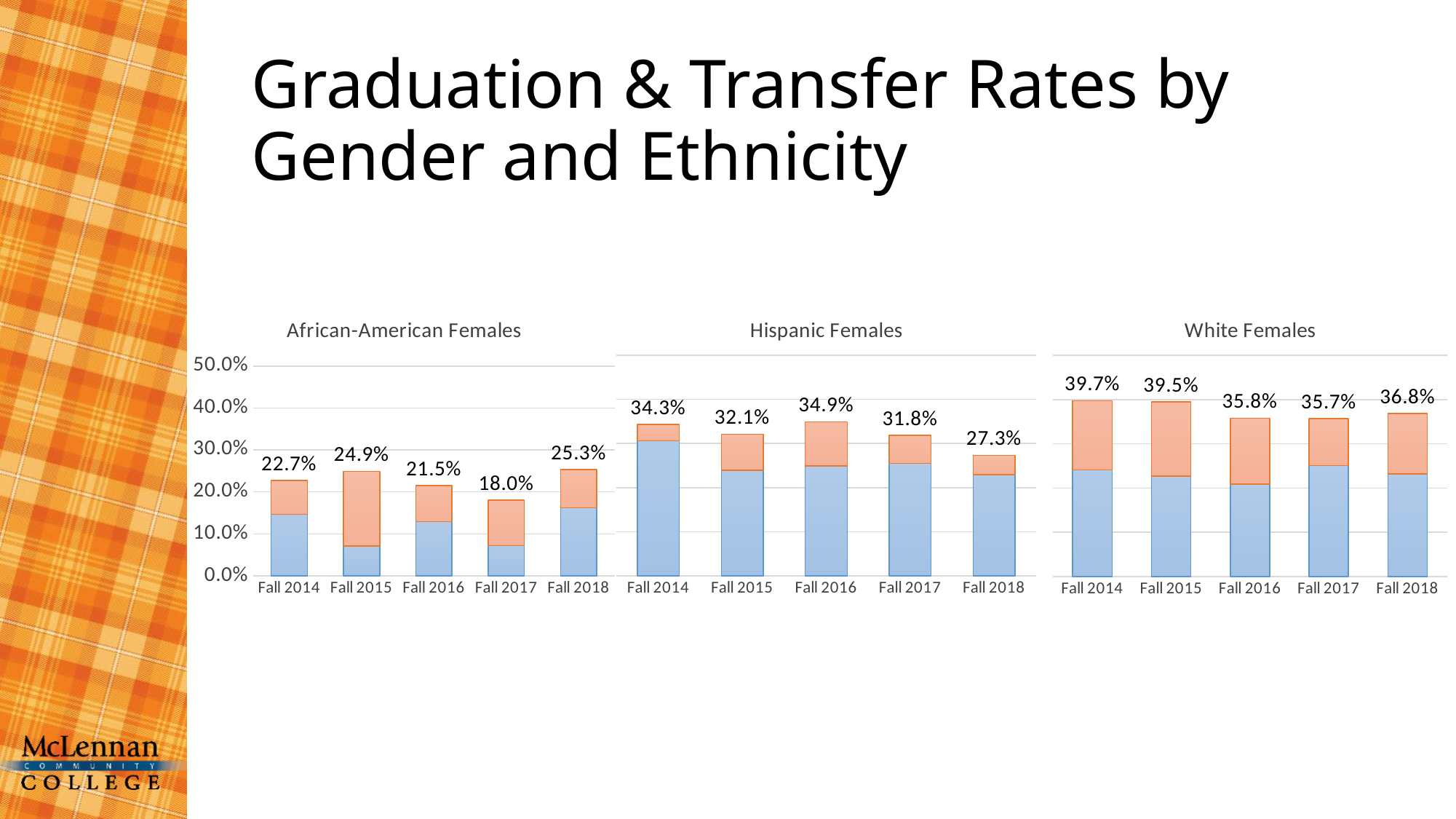
In the White Females chart, what is the total labeled for Fall 2018? 36.8% In the African-American Females chart, is the total for Fall 2017 greater or less than 20.0%? less How many separate charts are shown on the slide? 3 In the African-American Females chart, what is the total labeled for Fall 2015? 24.9% In the White Females chart, is the Fall 2016 total or the Fall 2018 total larger? Fall 2018 In the Hispanic Females chart, what is the difference between the Fall 2014 total and the Fall 2018 total? 7.0% What kind of chart is the White Females chart? stacked bar chart In the African-American Females chart, which term has the lowest total? Fall 2017 In the Hispanic Females chart, which term has the highest total? Fall 2016 In the White Females chart, which term has the highest total? Fall 2014 How many terms are shown on the x axis of the Hispanic Females chart? 5 In the Hispanic Females chart, what is the total labeled for Fall 2016? 34.9%